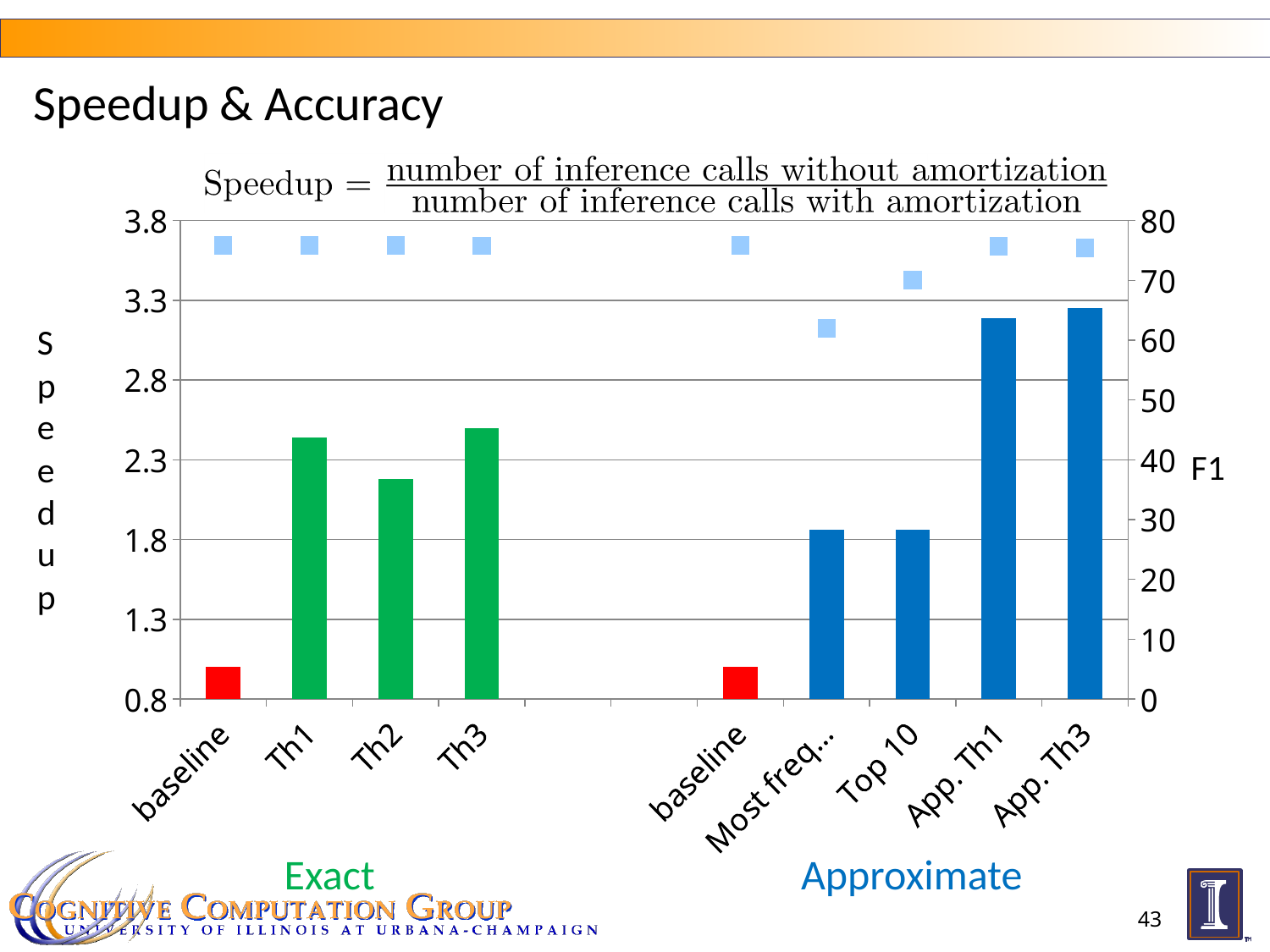
Is the speedup value for the baseline in the Exact group greater or less than 1.3? less Which category has the lowest F1 value? Most freq... What does the right-hand vertical axis of the chart measure? F1 What kind of chart is shown on the slide? bar chart Is the speedup value for App. Th1 greater or less than 2.8? greater Is the speedup value for Th2 greater or less than 2.3? less Which has the higher speedup, Th1 or Th2? Th1 How many categories are shown along the x axis of the chart? 9 What is the title of the slide containing the chart? Speedup & Accuracy Which has the higher speedup, App. Th1 or Th3? App. Th1